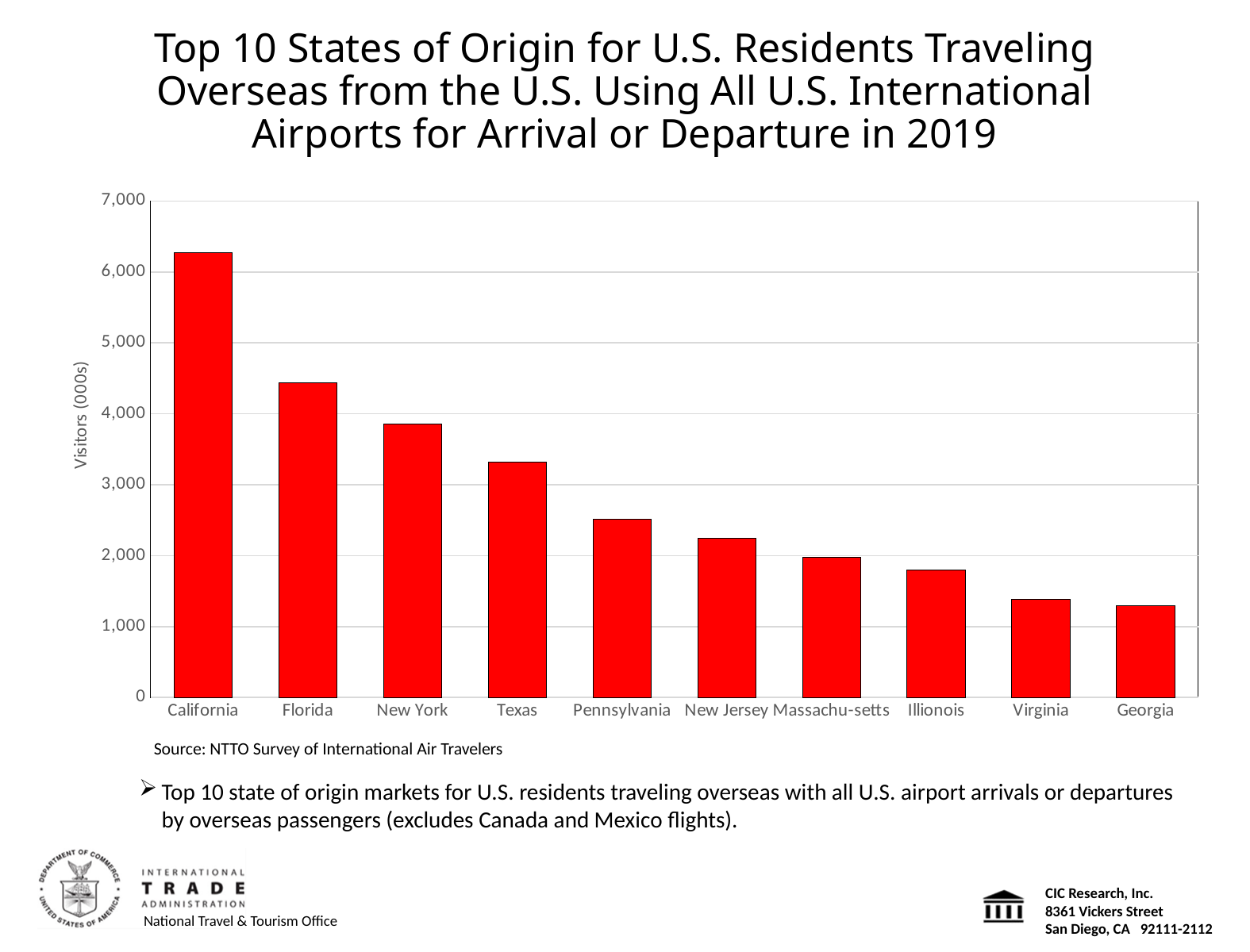
Is the value for Illinois greater or less than 2,000? less What is the label of the vertical axis of the chart? Visitors (000s) Do the values rise or fall moving from left to right along the x axis? fall Is the value for Florida greater or less than 4,000? greater Is the value for New York greater or less than 4,000? less Which has a larger value, Florida or New York? Florida What kind of chart is shown on the slide? bar chart Which state has the lowest number of visitors in the chart? Georgia How many states are shown on the x axis of the chart? 10 Which state has the highest number of visitors in the chart? California